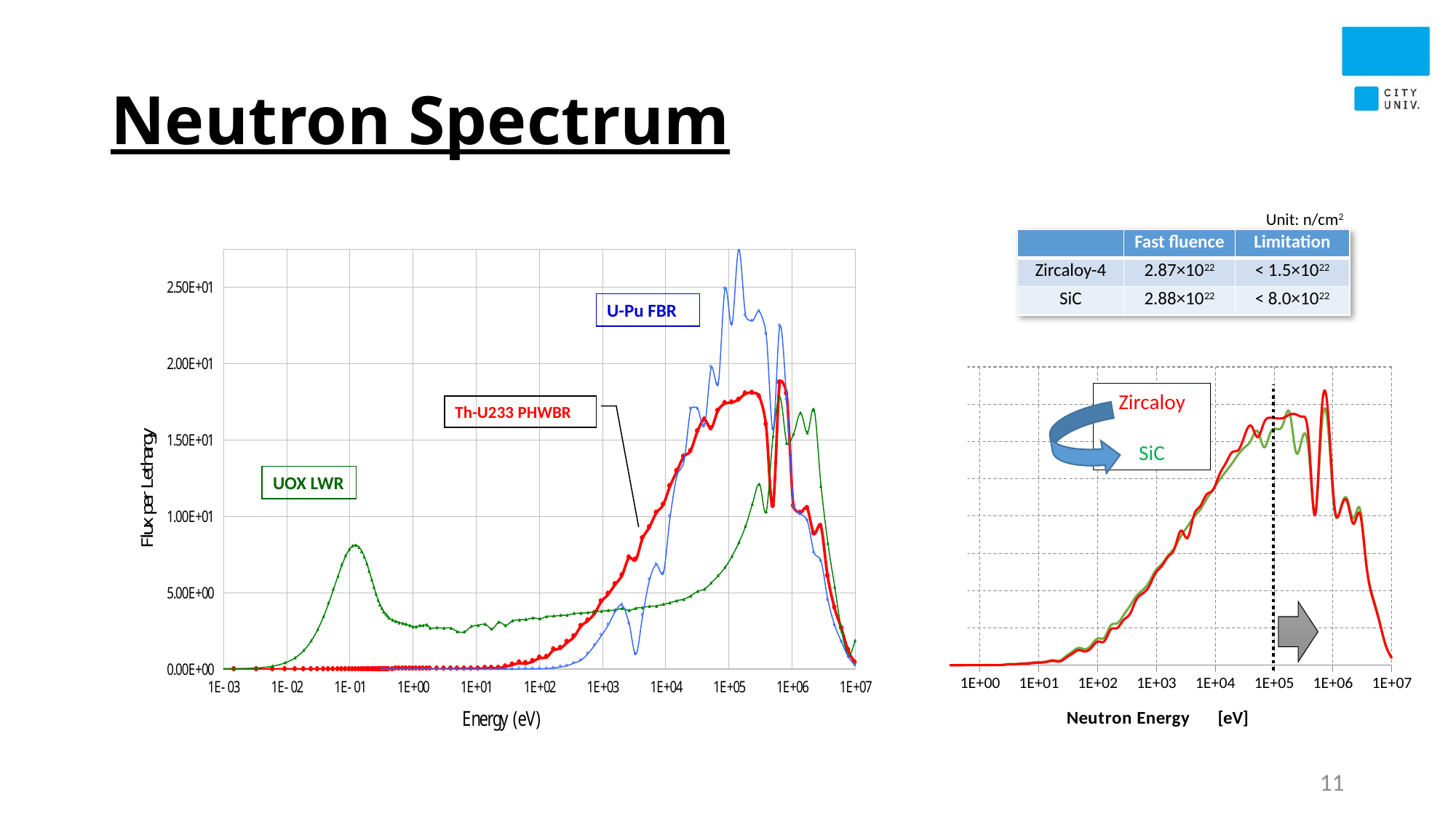
In the left chart (Flux per Lethargy vs Energy), is the peak of the UOX LWR curve near 1E-01 eV greater or less than 1.00E+01? less In the left chart (Flux per Lethargy vs Energy), which series reaches the highest peak value? U-Pu FBR What is the x-axis label of the left chart? Energy (eV) In the right chart (Zircaloy vs SiC), how many series are plotted? 2 What kind of chart is the left chart with the axis label 'Flux per Lethargy'? line chart In the left chart (Flux per Lethargy vs Energy), which series has a peak near 1E-01 eV? UOX LWR In the right chart (Zircaloy vs SiC), at which x-axis value is the vertical dotted line drawn? 1E+05 In the left chart (Flux per Lethargy vs Energy), which curve is higher at 1E+03 eV, Th-U233 PHWBR or UOX LWR? Th-U233 PHWBR In the left chart (Flux per Lethargy vs Energy), is the highest value of the U-Pu FBR curve greater or less than 2.50E+01? greater In the left chart (Flux per Lethargy vs Energy), is the highest value of the Th-U233 PHWBR curve greater or less than 1.50E+01? greater In the left chart (Flux per Lethargy vs Energy), how many reactor spectra (series) are labelled? 3 In the right chart (Zircaloy vs SiC), how many labelled tick values are shown on the x axis? 8